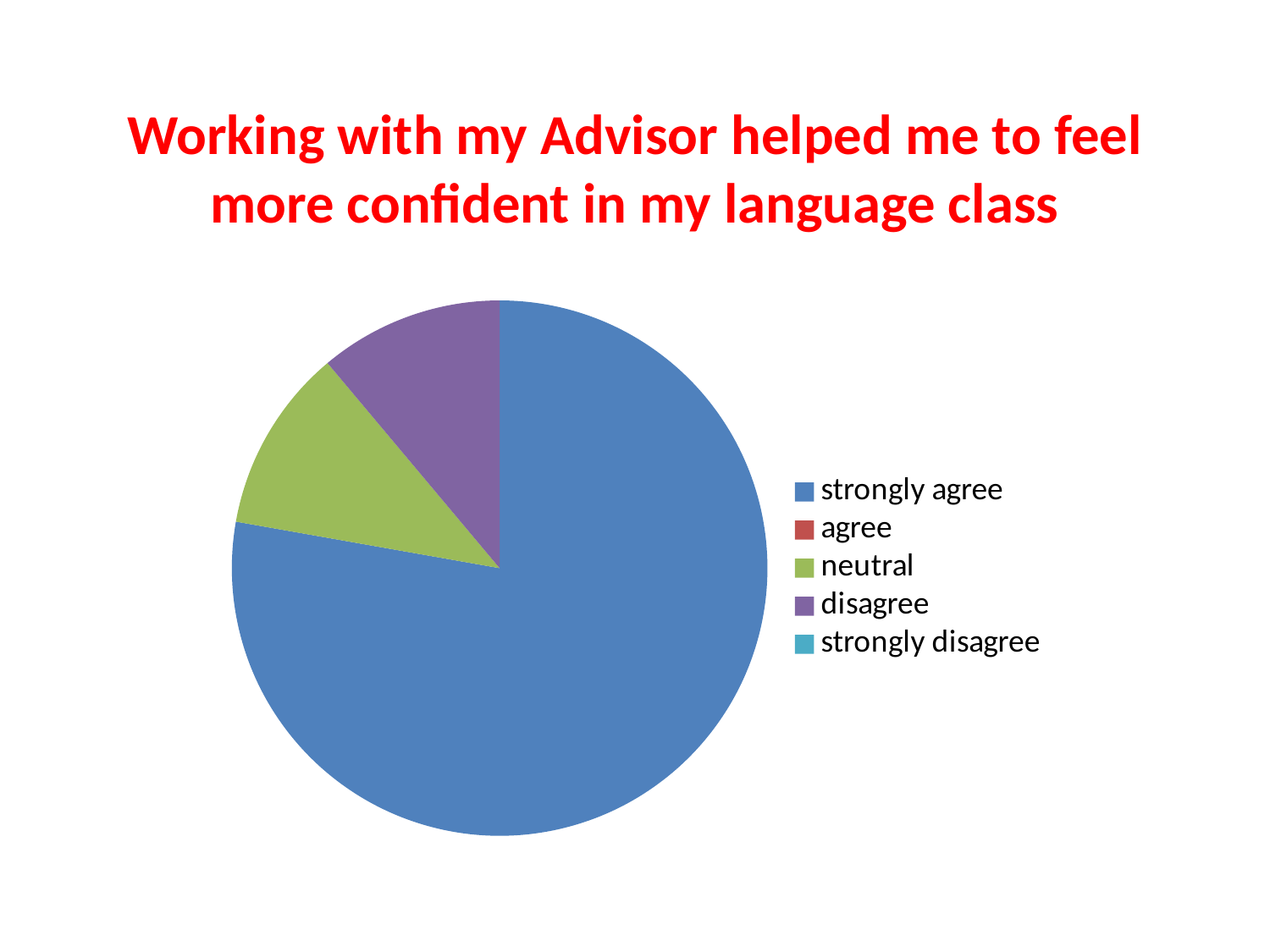
Which category has the largest slice of the pie? strongly agree How many slices are visible in the pie? 3 Does the strongly agree slice take up more or less than half of the pie? more How many categories does the legend list? 5 What colour is the strongly agree slice? blue What is the title of the chart? Working with my Advisor helped me to feel more confident in my language class Which slice is larger, strongly agree or disagree? strongly agree What kind of chart is shown on the slide? pie chart Which slice is larger, strongly agree or neutral? strongly agree